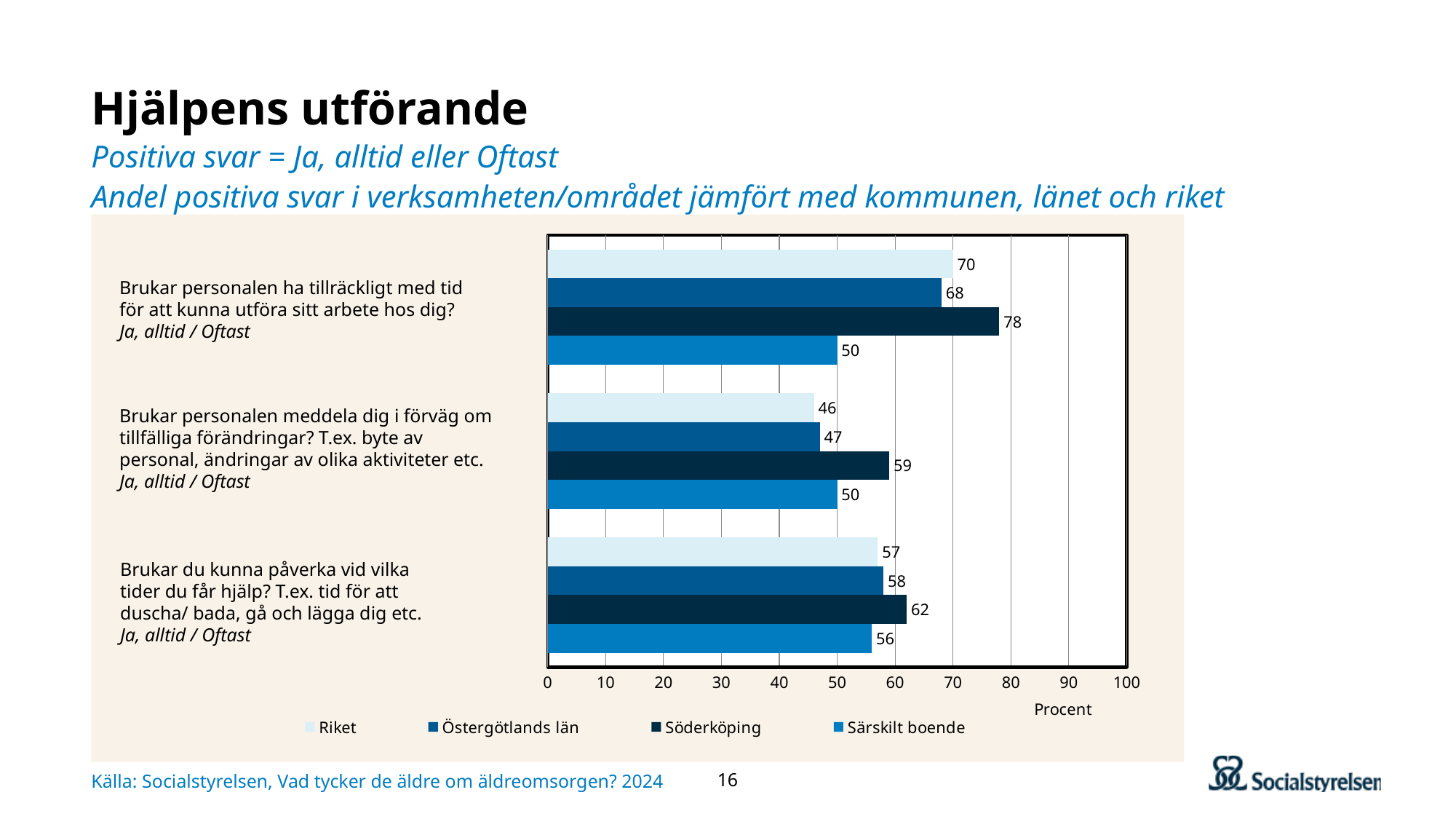
What is the difference between Söderköping and Särskilt boende on the question 'Brukar personalen ha tillräckligt med tid för att kunna utföra sitt arbete hos dig?' 28 Which series has the highest value on the question 'Brukar personalen ha tillräckligt med tid för att kunna utföra sitt arbete hos dig?' Söderköping What is the value for Särskilt boende on the question 'Brukar personalen meddela dig i förväg om tillfälliga förändringar?' 50 What is the label of the x axis of the chart? Procent How many series does the legend list? 4 On the question 'Brukar du kunna påverka vid vilka tider du får hjälp?', which is larger: Söderköping or Särskilt boende? Söderköping What is the value for Söderköping on the question 'Brukar personalen ha tillräckligt med tid för att kunna utföra sitt arbete hos dig?' 78 What is the value for Riket on the question 'Brukar du kunna påverka vid vilka tider du får hjälp?' 57 Which series has the lowest value on the question 'Brukar personalen meddela dig i förväg om tillfälliga förändringar?' Riket How many question categories are plotted on the chart? 3 Is the value for Riket on the question 'Brukar personalen meddela dig i förväg om tillfälliga förändringar?' greater or less than 50? less What type of chart is shown on the slide? bar chart